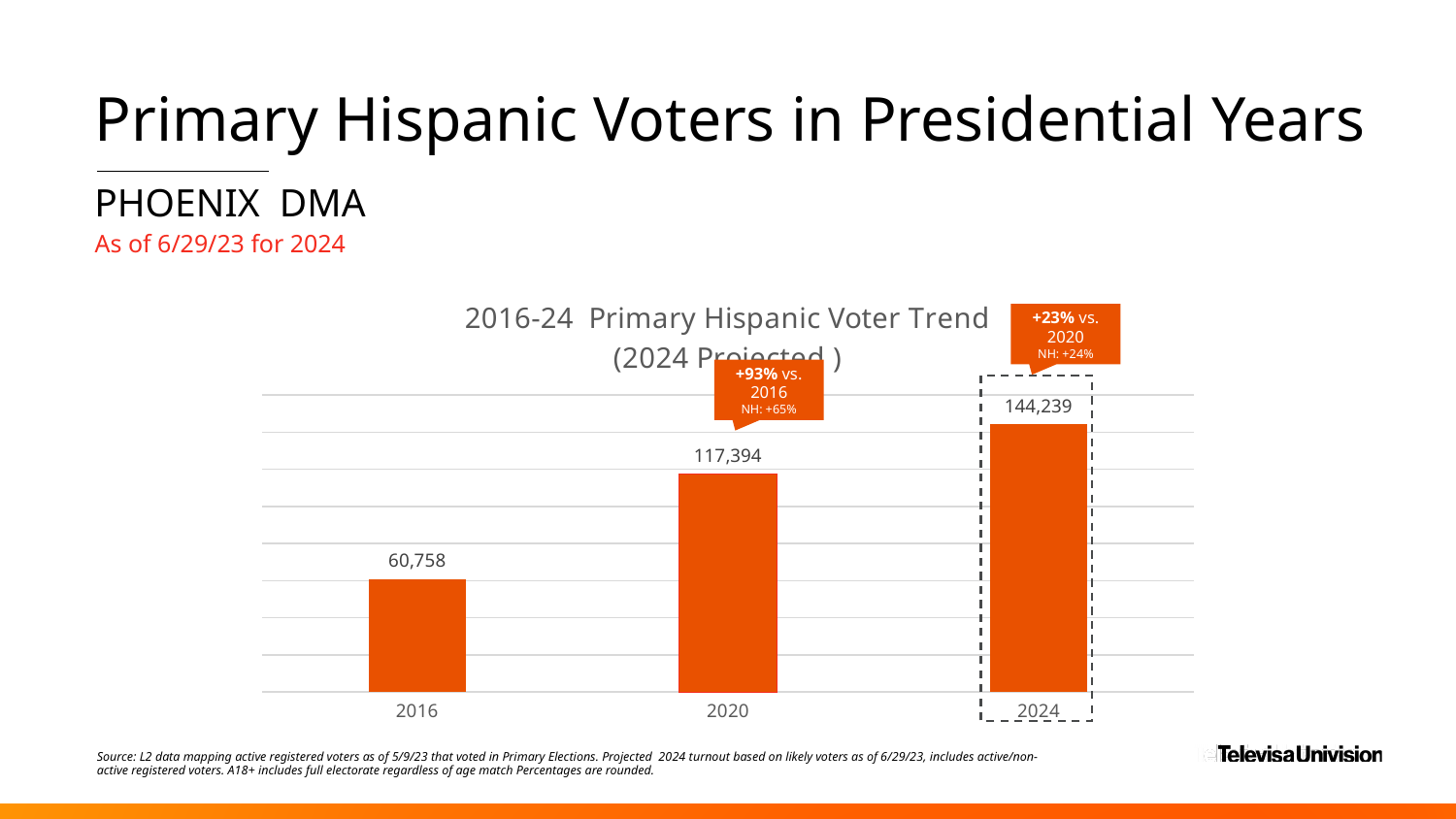
What is the projected value for 2024? 144,239 What is the difference between the 2024 and 2020 values? 26,845 Which is larger, the value for 2020 or the value for 2024? 2024 Which year has the highest value? 2024 What is the difference between the 2020 and 2016 values? 56,636 According to the callout, what is the percentage change for 2024 vs. 2020? +23% Which year has the lowest value? 2016 What is the value for 2016? 60,758 What kind of chart is shown? Bar chart Do the values rise or fall from 2016 to 2024? Rise What is the value for 2020? 117,394 How many years are shown on the chart? 3